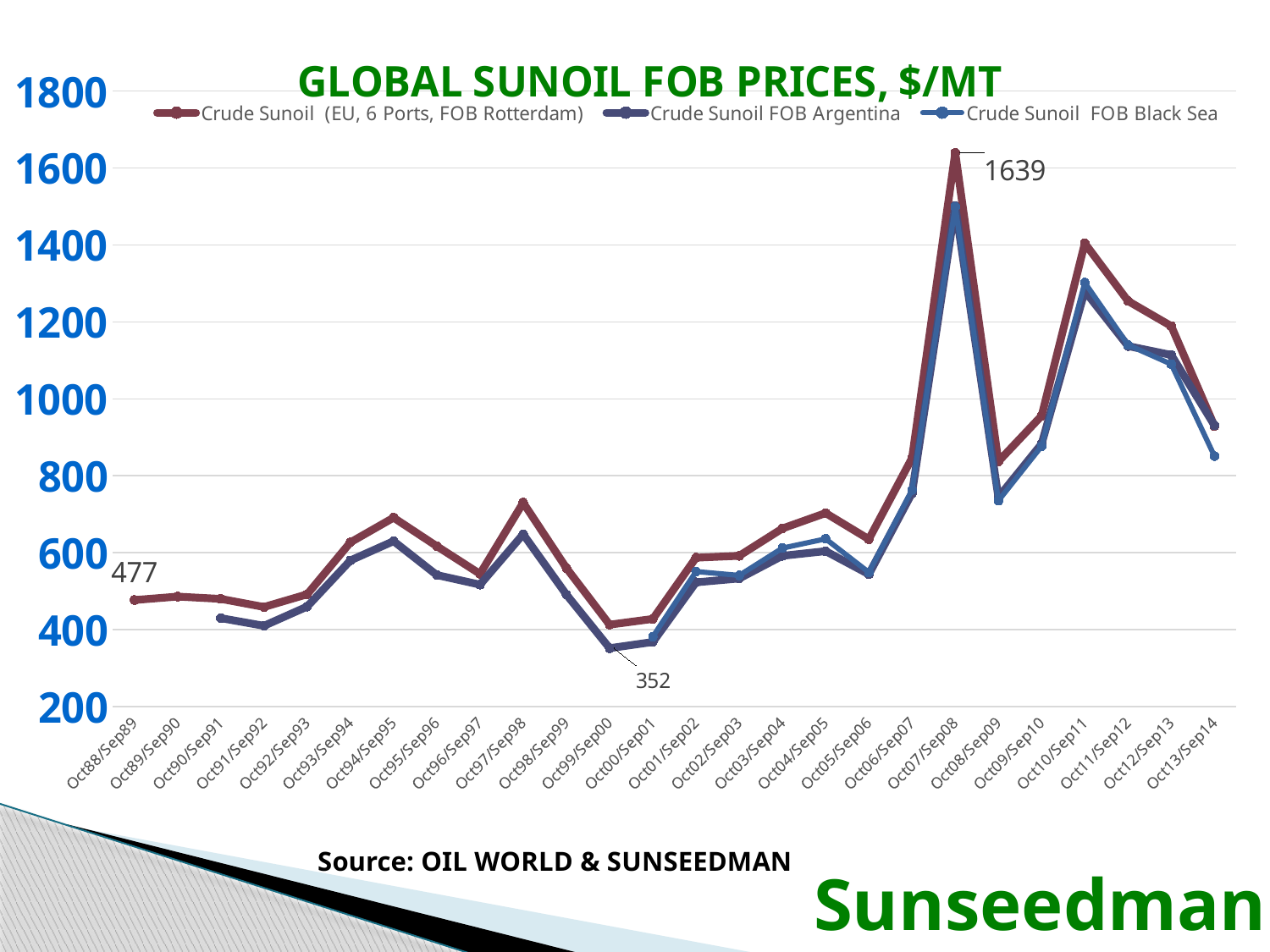
What is the title of the chart? GLOBAL SUNOIL FOB PRICES, $/MT What is the difference between the labelled Rotterdam values at Oct07/Sep08 (1639) and Oct88/Sep89 (477)? 1162 What type of chart is shown on the slide? Line chart Is the value for Crude Sunoil FOB Black Sea at Oct13/Sep14 greater or less than 1000? less What is the labelled peak value for Crude Sunoil (EU, 6 Ports, FOB Rotterdam) at Oct07/Sep08? 1639 At Oct07/Sep08, which is higher: Crude Sunoil (EU, 6 Ports, FOB Rotterdam) or Crude Sunoil FOB Black Sea? Crude Sunoil (EU, 6 Ports, FOB Rotterdam) What is the labelled value for Crude Sunoil (EU, 6 Ports, FOB Rotterdam) at Oct88/Sep89? 477 What is the lowest value labelled on the chart, at Oct99/Sep00? 352 How many series does the legend list? 3 In which period does Crude Sunoil (EU, 6 Ports, FOB Rotterdam) reach its highest value? Oct07/Sep08 Is the value for Crude Sunoil (EU, 6 Ports, FOB Rotterdam) at Oct10/Sep11 greater or less than 1200? greater How many periods are shown along the x axis? 26